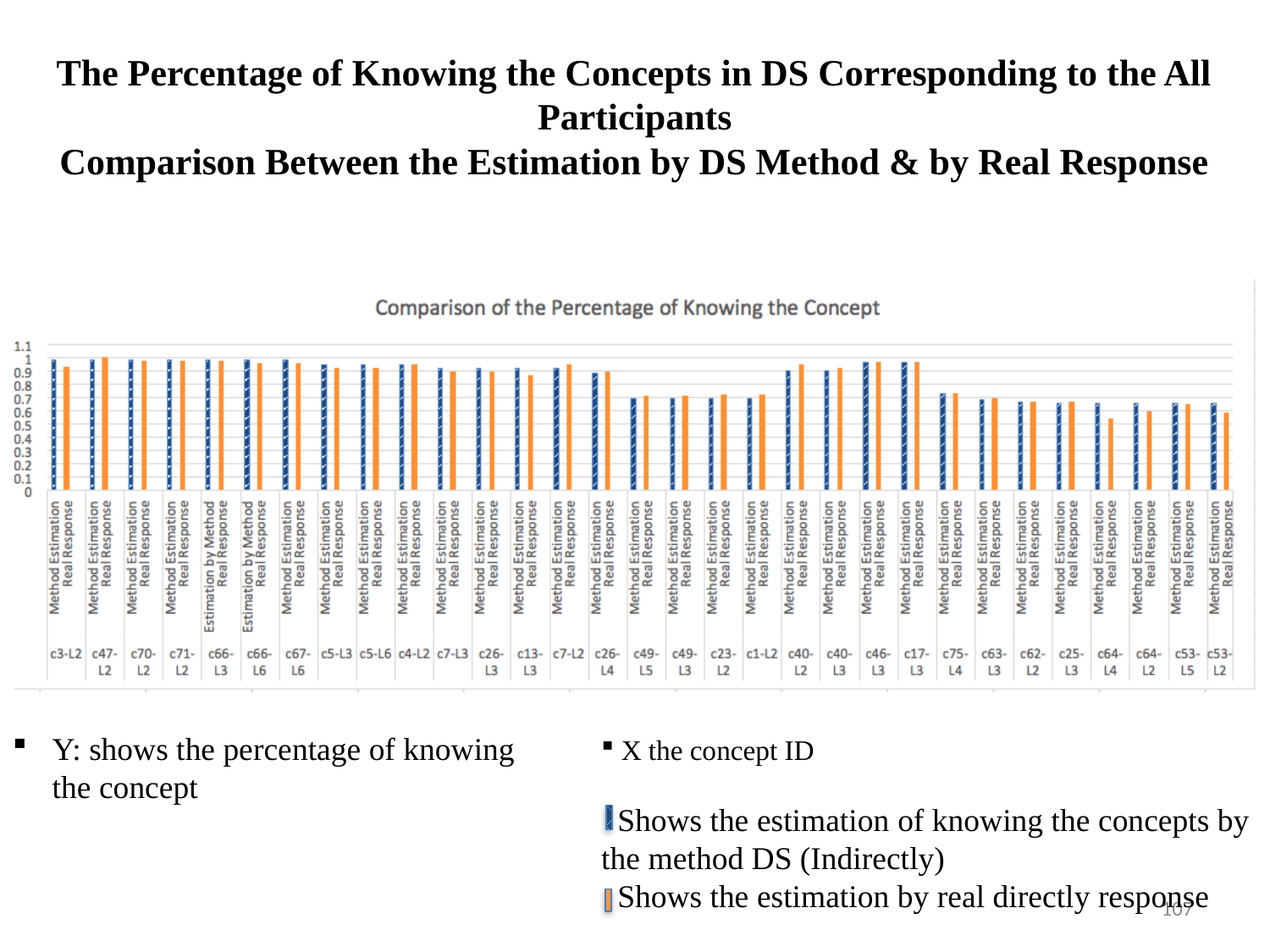
Do the Method Estimation values generally rise or fall from left to right along the x axis? Fall How many concept IDs are shown along the x axis of the chart? 31 Is the Method Estimation value for c75-L4 greater or less than 0.8? less What is the title of the chart? Comparison of the Percentage of Knowing the Concept For c64-L4, which is larger: the Method Estimation bar or the Real Response bar? Method Estimation Is the Real Response value for c49-L5 greater or less than 0.5? greater Is the Real Response value for c64-L4 greater or less than 0.7? less How many series (bars per concept) does the chart show? 2 What kind of chart is shown on the slide? Bar chart Which colour represents the Real Response bars in the chart? Orange